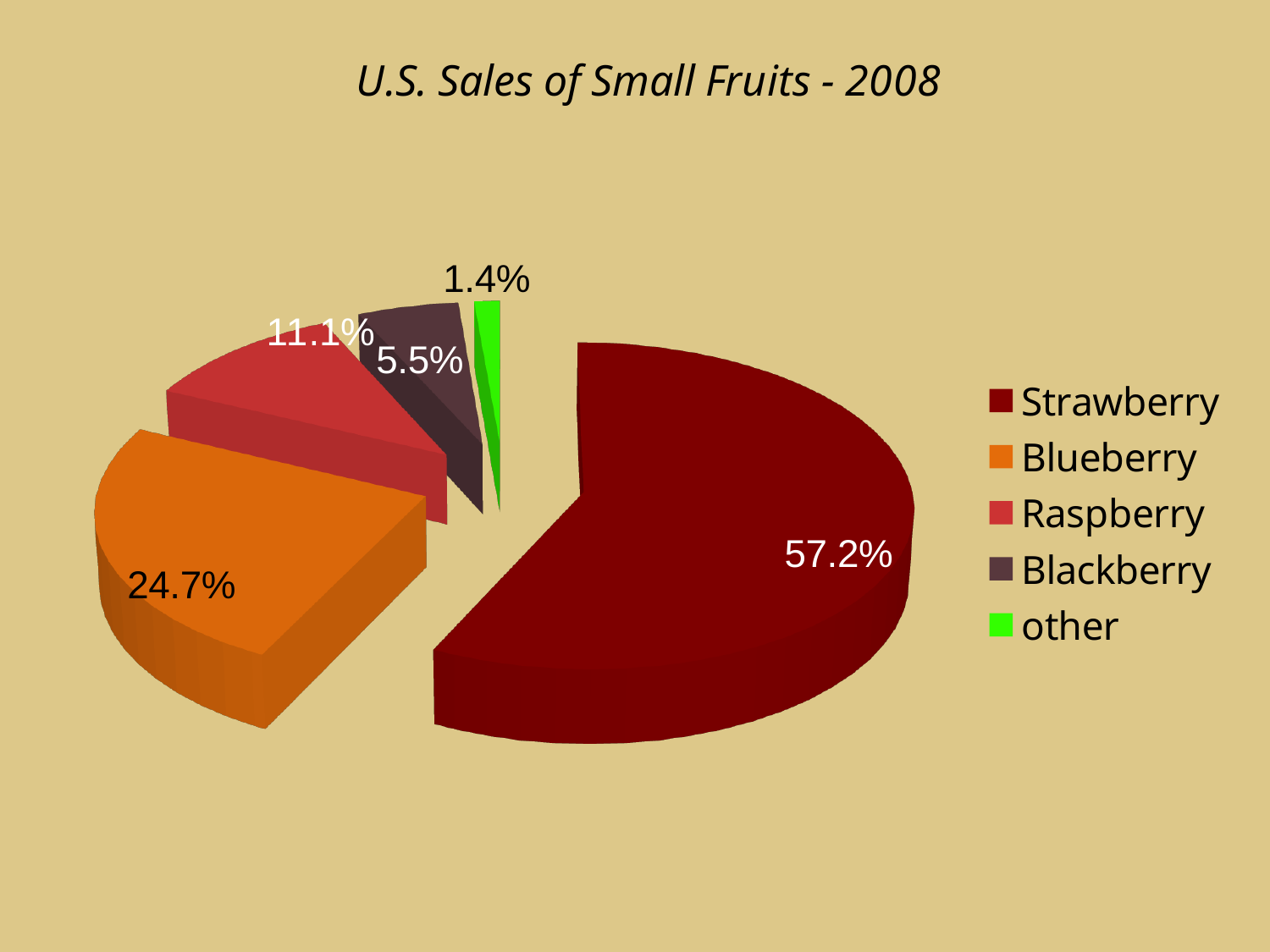
Which category has the largest share of the pie? Strawberry How many slices does the pie chart have? 5 What is the value shown for Blackberry? 5.5% What is the difference in percentage points between Strawberry and Blueberry? 32.5 What is the title of the chart? U.S. Sales of Small Fruits - 2008 What share of U.S. small fruit sales in 2008 does Strawberry hold? 57.2% What is the value shown for the 'other' slice? 1.4% What kind of chart is shown on the slide? Pie chart Which is larger, the Raspberry share or the Blackberry share? Raspberry What is the value shown for Blueberry? 24.7% Which category has the smallest share of the pie? other What is the value shown for Raspberry? 11.1%